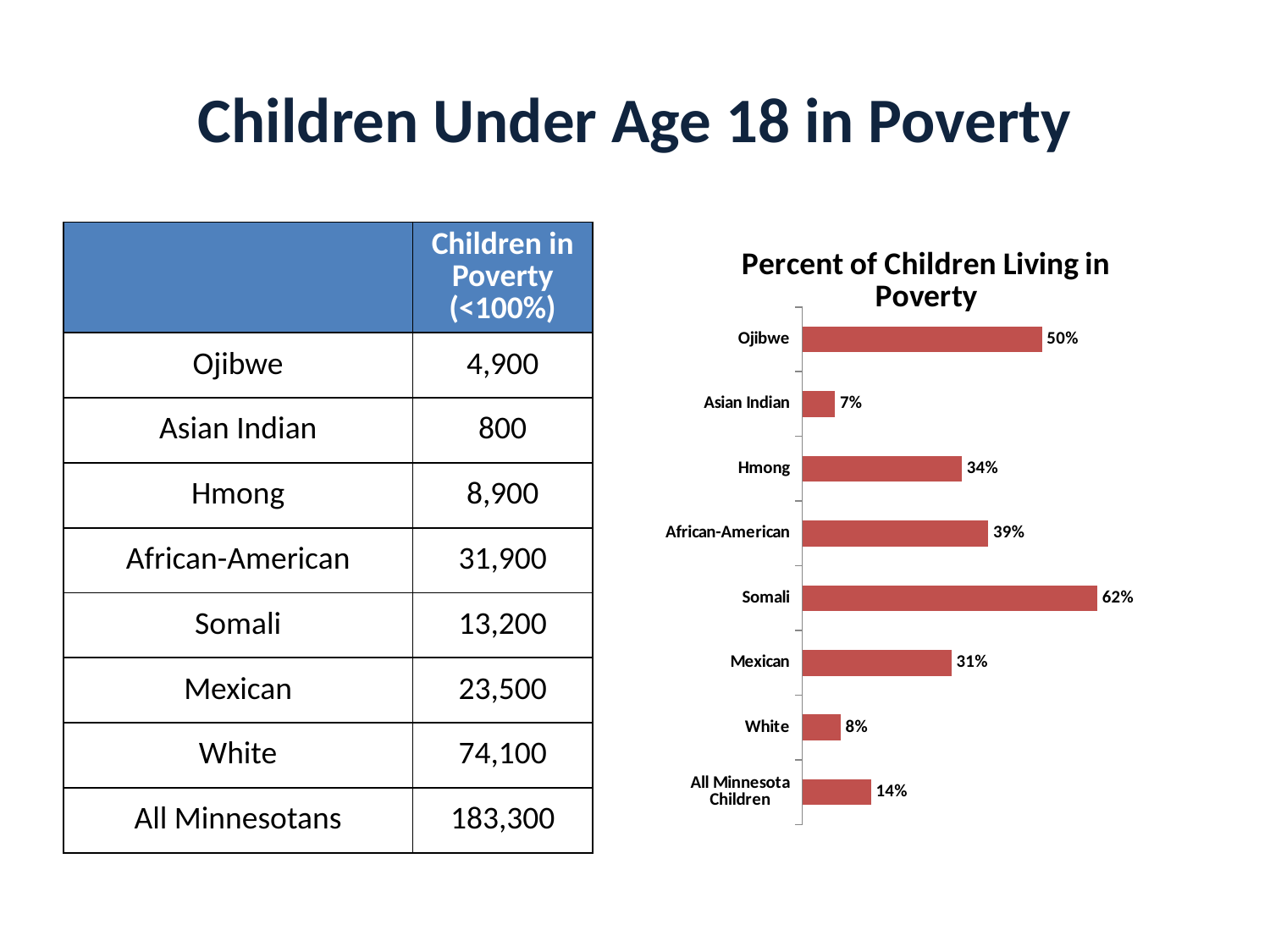
What kind of chart is shown on the slide? Bar chart What is the percent of children living in poverty for All Minnesota Children? 14% Which category has the lowest percent of children living in poverty? Asian Indian Which has a higher percent of children living in poverty, Mexican or Hmong? Hmong What is the percent of children living in poverty for Somali? 62% What colour are the bars in the chart? Red Which category has the highest percent of children living in poverty? Somali What is the title of the chart? Percent of Children Living in Poverty What is the difference in percentage points between Somali and African-American? 23 What is the difference in percentage points between Ojibwe and White? 42 How many categories are shown in the chart? 8 What is the percent of children living in poverty for Hmong? 34%